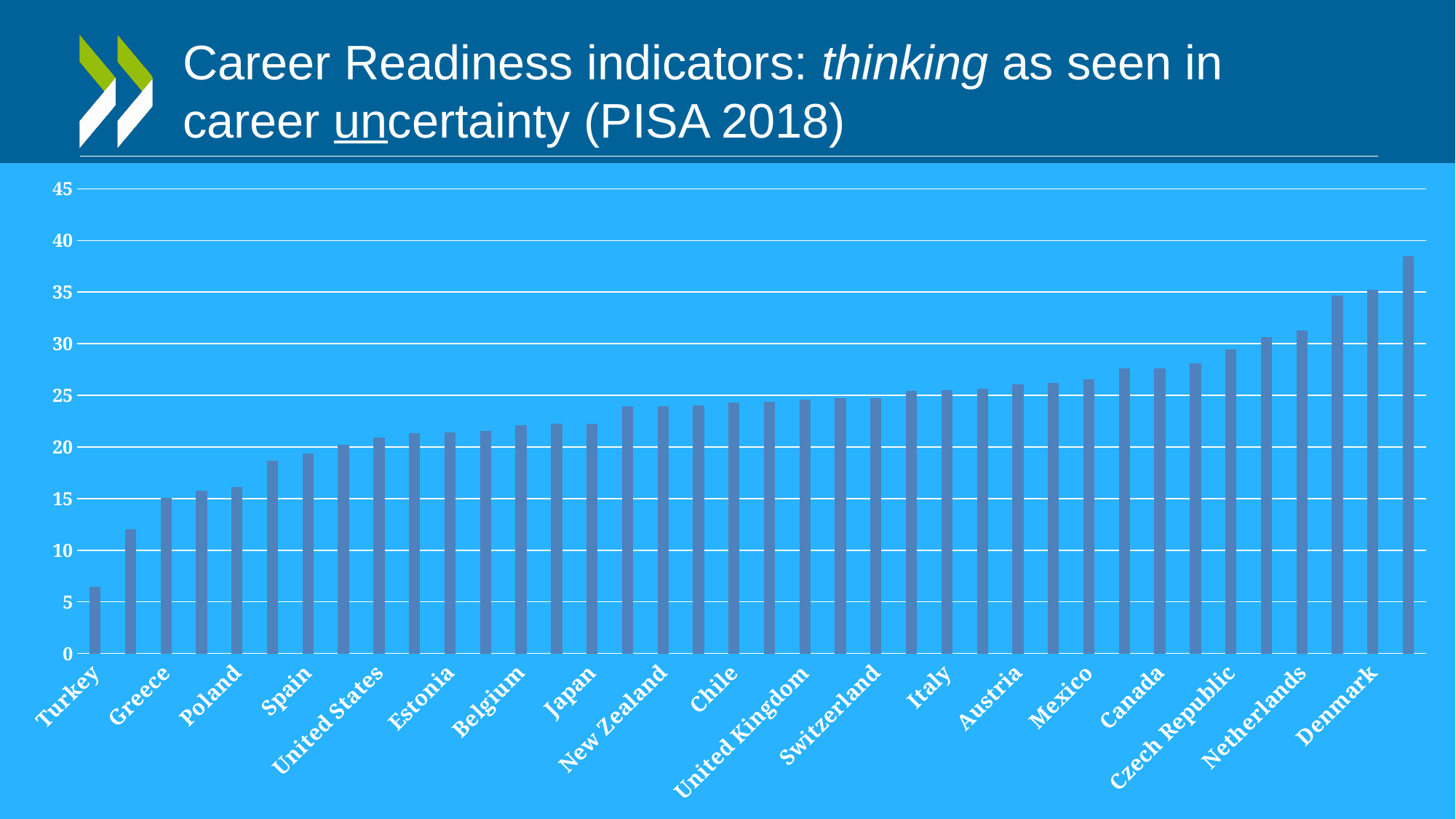
Is the value for Spain greater or less than 20? less Is the value for New Zealand greater or less than 25? less Which has a larger value, Denmark or Greece? Denmark Is the value for Canada greater or less than 30? less Which country has the lowest value in the chart? Turkey What kind of chart is shown on the slide? bar chart Do the values generally rise or fall moving from left to right along the x axis? rise Which PISA year is referenced in the slide title? 2018